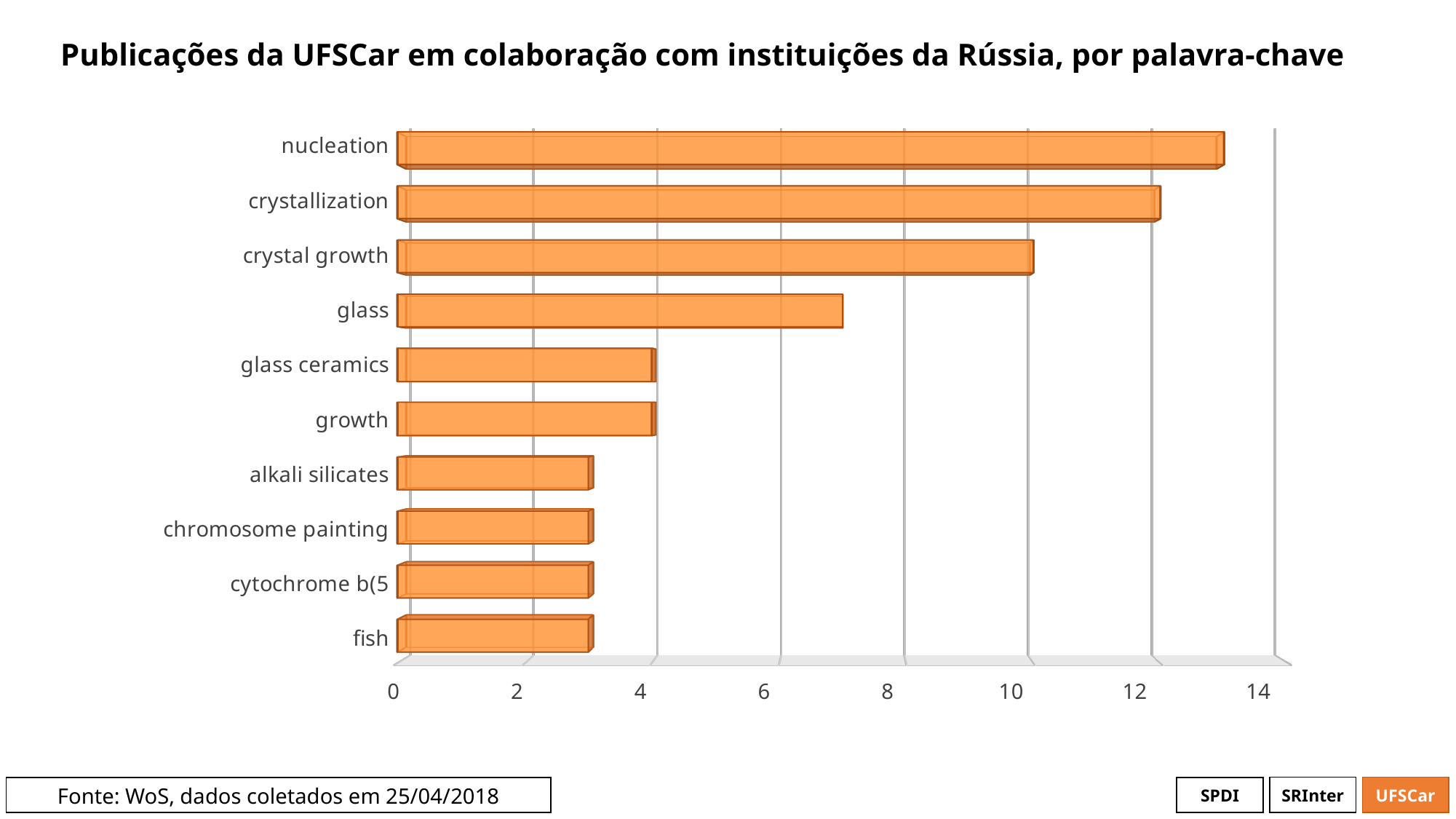
Is the value for alkali silicates greater or less than 2? greater Is the value for glass greater or less than 8? less What is the title of the chart? Publicações da UFSCar em colaboração com instituições da Rússia, por palavra-chave Is the value for glass greater or less than 6? greater Which keyword has the highest number of publications? nucleation Which is larger, the value for glass or the value for glass ceramics? glass What kind of chart is shown on the slide? bar chart Which is larger, the value for crystallization or the value for crystal growth? crystallization How many keywords (categories) are shown in the chart? 10 What is the maximum value shown on the horizontal axis? 14